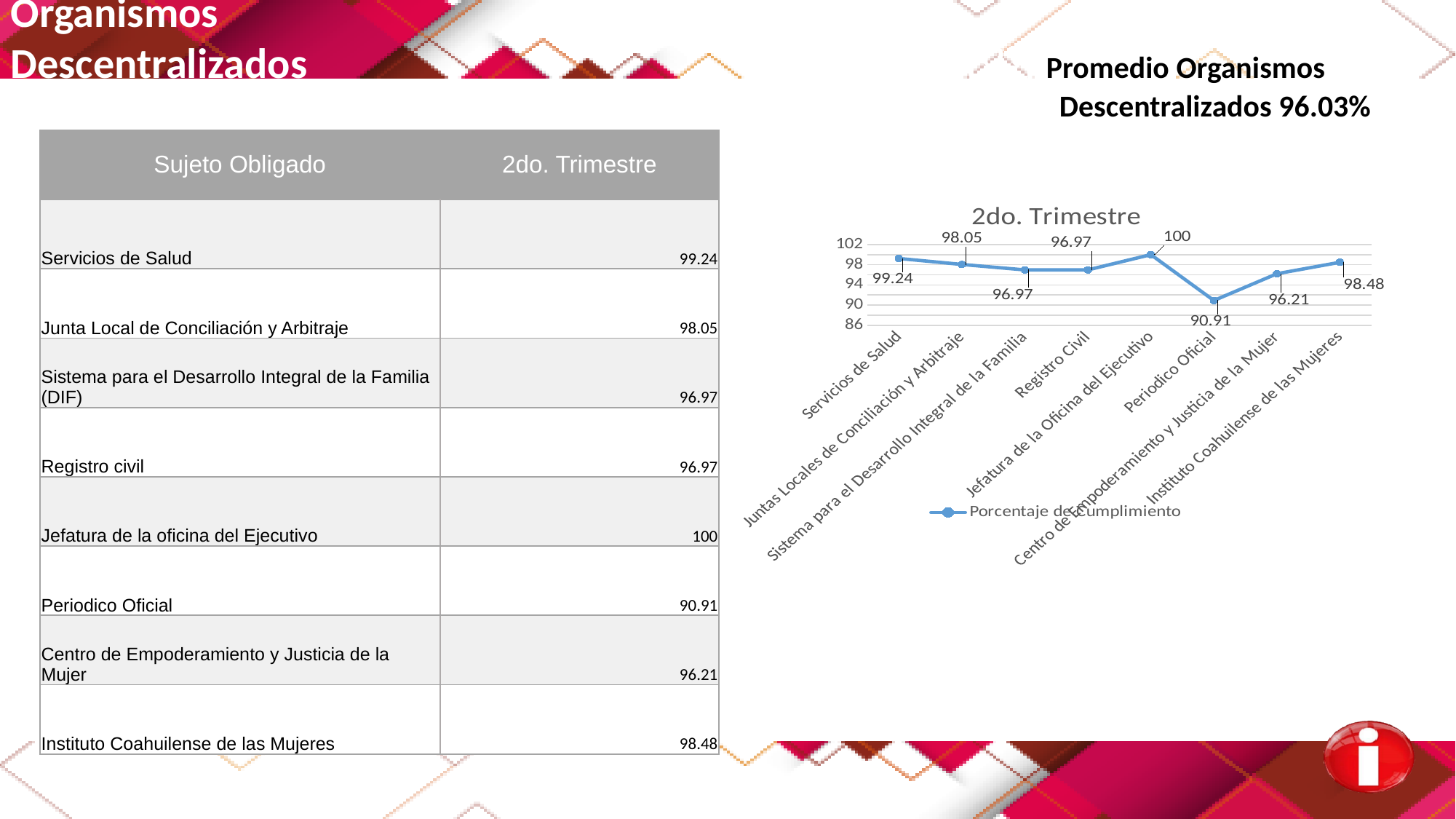
How many categories are plotted in the chart? 8 What is the value for Periodico Oficial in the chart? 90.91 Which is larger, the value for Juntas Locales de Conciliación y Arbitraje or the value for Centro de Empoderamiento y Justicia de la Mujer? Juntas Locales de Conciliación y Arbitraje What is the difference between the values for Jefatura de la Oficina del Ejecutivo and Periodico Oficial? 9.09 What type of chart is shown on the slide? Line chart Which category has the highest value in the chart? Jefatura de la Oficina del Ejecutivo What is the title of the chart? 2do. Trimestre What is the name of the series shown in the chart legend? Porcentaje de Cumplimiento How many series does the chart legend list? 1 What is the value for Instituto Coahuilense de las Mujeres in the chart? 98.48 What is the value for Servicios de Salud in the chart? 99.24 Which category has the lowest value in the chart? Periodico Oficial